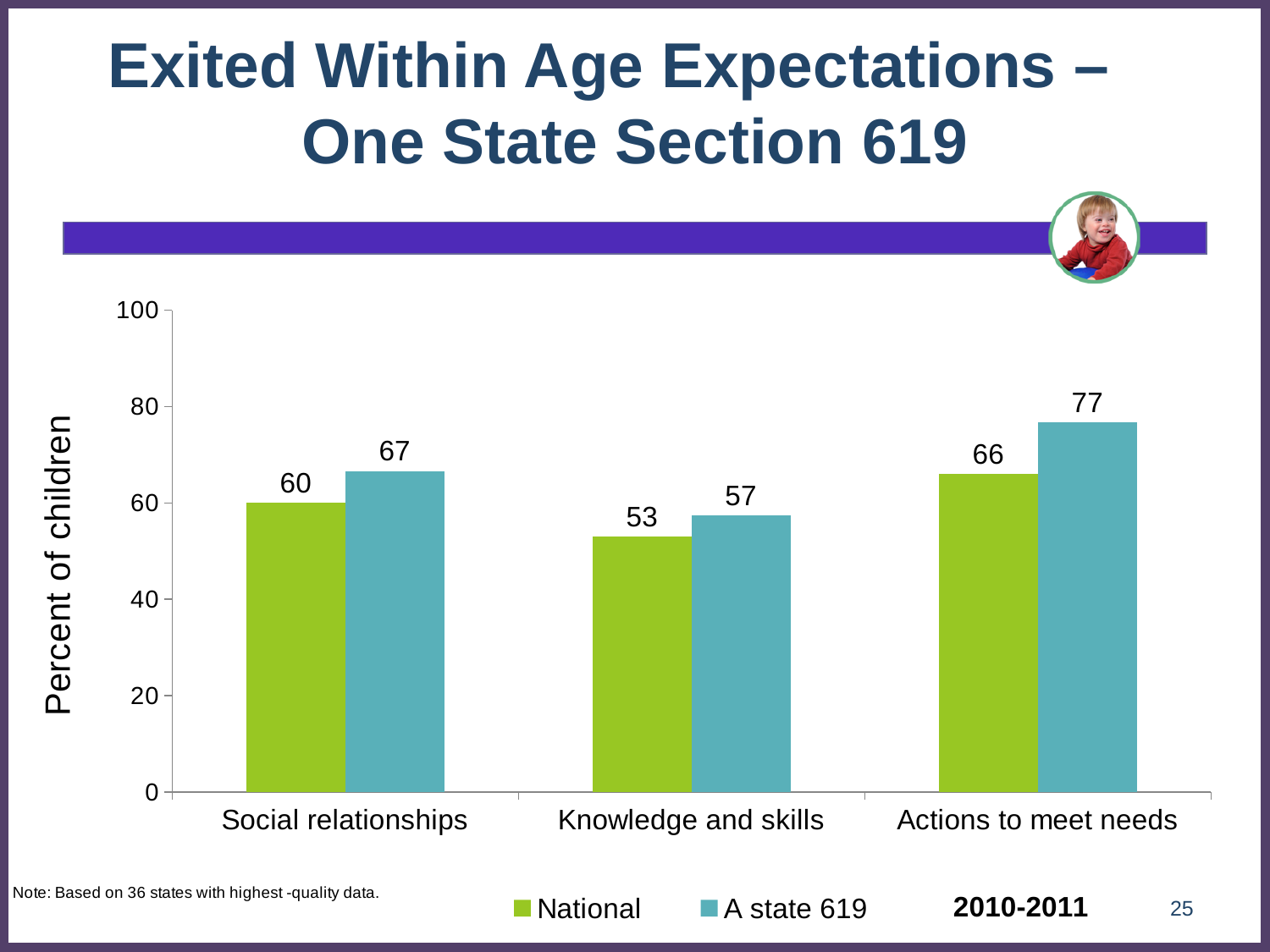
Which category has the lowest National value? Knowledge and skills What is the A state 619 value for Knowledge and skills? 57 How many series does the legend list? 2 What is the A state 619 value for Actions to meet needs? 77 What is the National value for Knowledge and skills? 53 Which category has the highest A state 619 value? Actions to meet needs How many categories are shown on the x axis? 3 Which is larger for Social relationships, the National value or the A state 619 value? A state 619 What is the difference between the A state 619 and National values for Actions to meet needs? 11 What kind of chart is shown on the slide? bar chart Is the National value for Actions to meet needs greater or less than 80? less What is the National value for Social relationships? 60